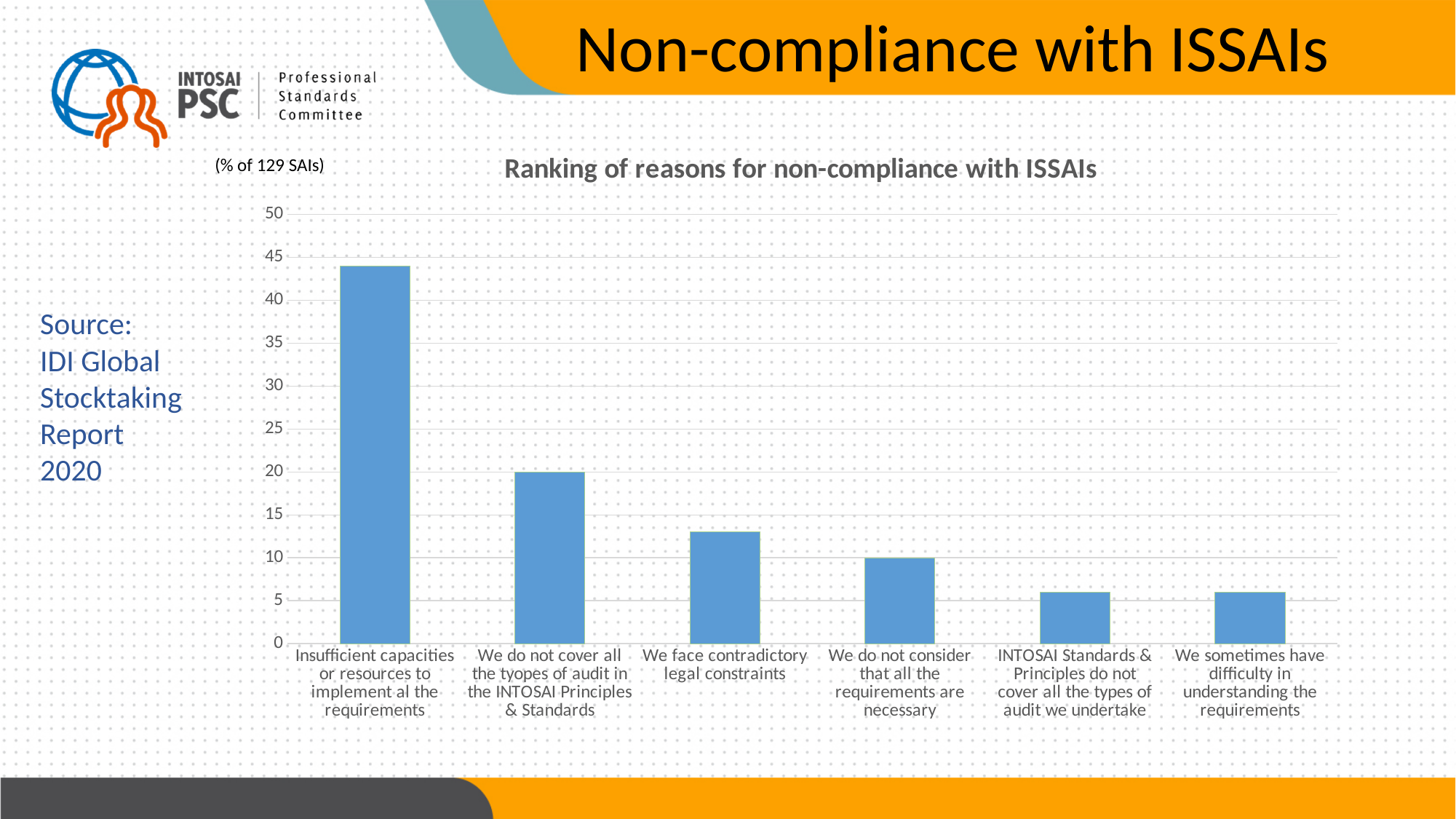
What unit is indicated for the values in the chart, as noted above the y axis? % of 129 SAIs What is the title of the chart? Ranking of reasons for non-compliance with ISSAIs What kind of chart is shown on the slide? bar chart Do the bar values rise or fall from left to right across the chart? fall Which reason has the highest value in the chart? Insufficient capacities or resources to implement al the requirements Is the value for 'We do not cover all the tyopes of audit in the INTOSAI Principles & Standards' greater or less than 25? less Is the value for 'We sometimes have difficulty in understanding the requirements' greater or less than 10? less How many reasons (categories) are plotted in the chart? 6 Which is larger: the value for 'We face contradictory legal constraints' or the value for 'INTOSAI Standards & Principles do not cover all the types of audit we undertake'? We face contradictory legal constraints Is the value for 'We face contradictory legal constraints' greater or less than 10? greater